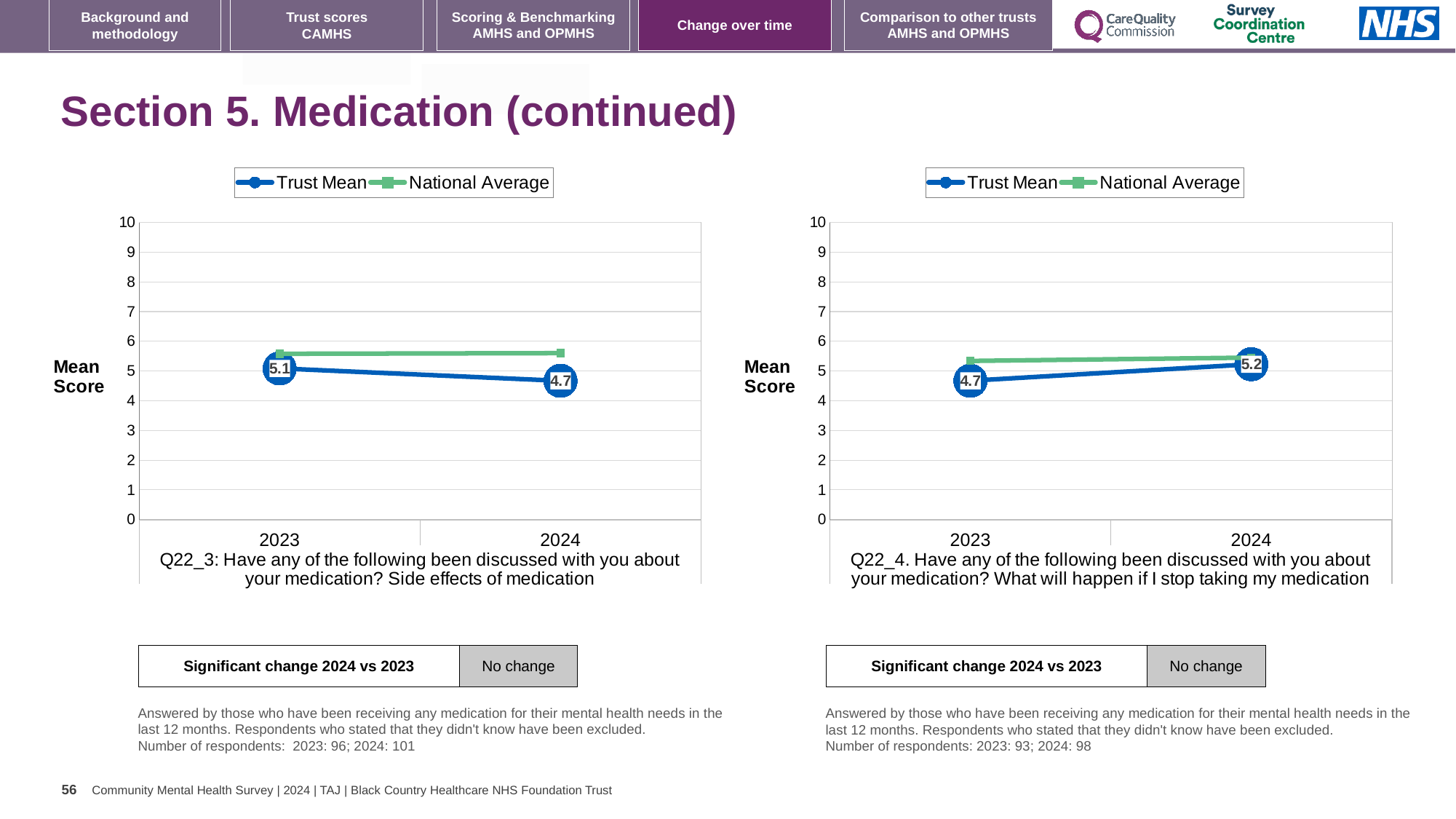
In the right chart (Q22_4), what is the difference between the Trust Mean in 2024 and in 2023? 0.5 How many series does the legend of the left chart (Q22_3) list? 2 In the left chart (Q22_3), what is the Trust Mean for 2024? 4.7 In the right chart (Q22_4), what is the Trust Mean for 2023? 4.7 What kind of chart is the right chart (Q22_4)? line chart In the right chart (Q22_4), what is the Trust Mean for 2024? 5.2 In the left chart (Q22_3), by how much did the Trust Mean change from 2023 to 2024? 0.4 In the left chart (Q22_3), what is the Trust Mean for 2023? 5.1 In the right chart (Q22_4), does the Trust Mean rise or fall from 2023 to 2024? rise In the left chart (Q22_3), does the Trust Mean rise or fall from 2023 to 2024? fall In the left chart (Q22_3), is the National Average for 2024 greater or less than 5? greater In the right chart (Q22_4), which is larger in 2023, the Trust Mean or the National Average? National Average